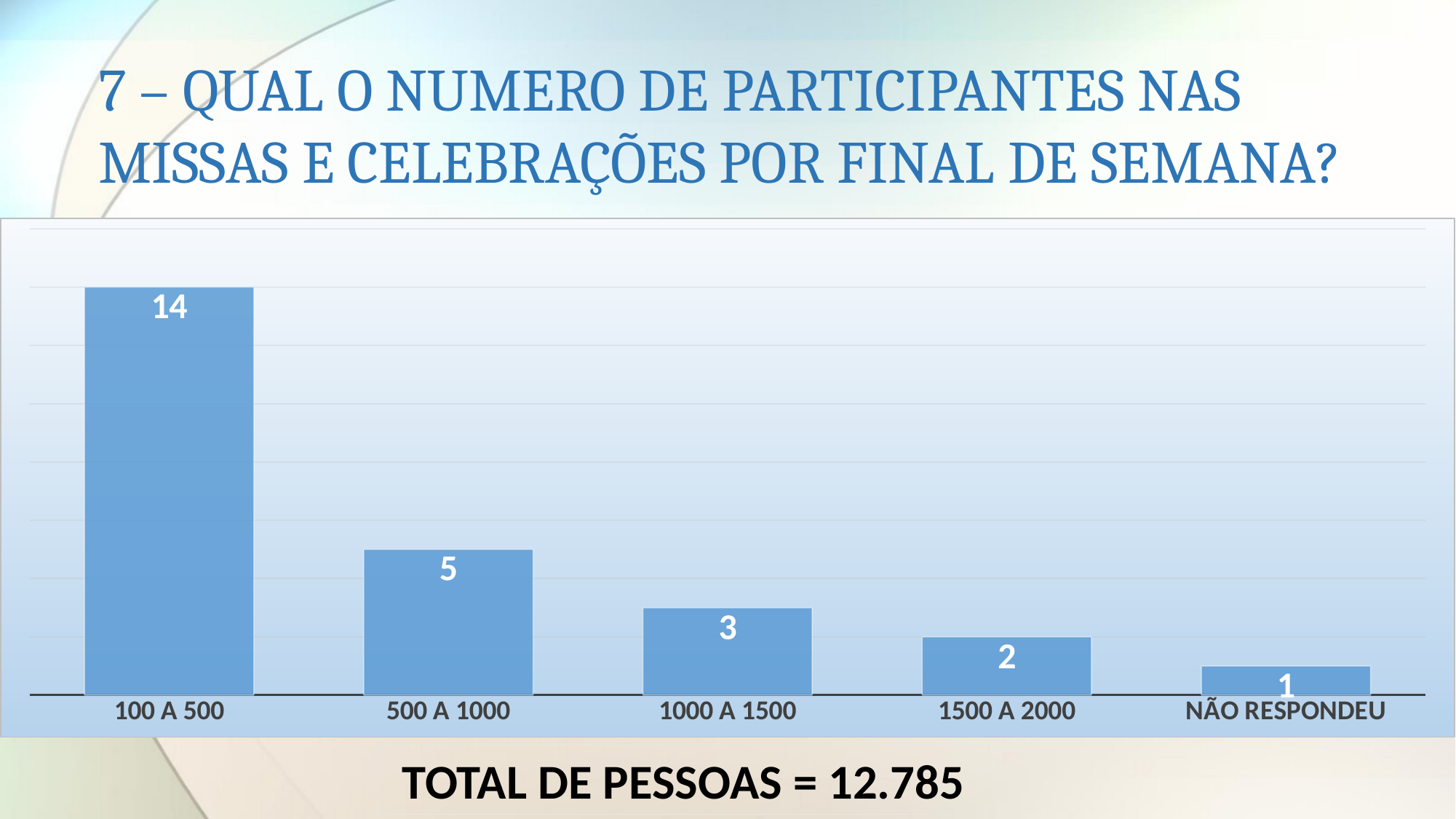
What is the value for the category NÃO RESPONDEU? 1 Which is larger, the value for 1000 A 1500 or the value for 1500 A 2000? 1000 A 1500 What is the difference between the values for 100 A 500 and 500 A 1000? 9 What is the value for the category 100 A 500? 14 Do the values rise or fall from left to right along the x axis? fall What total number of people is stated below the chart? 12.785 What is the value for the category 500 A 1000? 5 How many categories are shown on the chart? 5 Which category has the lowest value? NÃO RESPONDEU What kind of chart is shown on the slide? bar chart Which category has the highest value? 100 A 500 What is the value for the category 1000 A 1500? 3